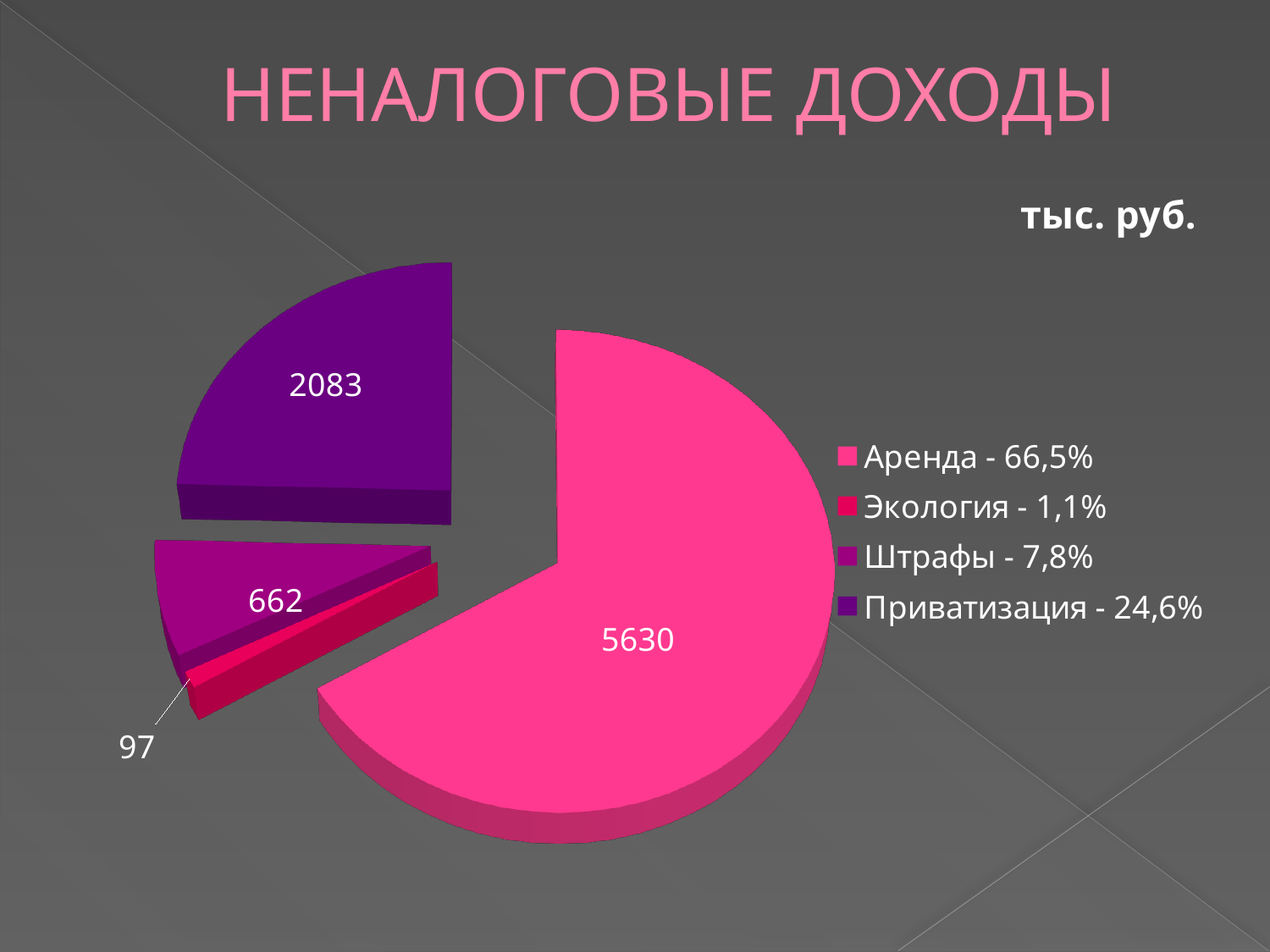
What is the difference between the values for Аренда and Приватизация? 3547 What is the value for Экология? 97 What is the value for Штрафы? 662 Which category has the largest slice? Аренда How many slices does the pie chart have? 4 What is the value for Приватизация? 2083 What share of the pie does Приватизация represent, according to the legend? 24,6% What type of chart is shown on the slide? Pie chart Which category has the smallest slice? Экология What is the value for Аренда? 5630 Which is larger, the value for Штрафы or the value for Приватизация? Приватизация What unit is indicated for the chart values? тыс. руб.